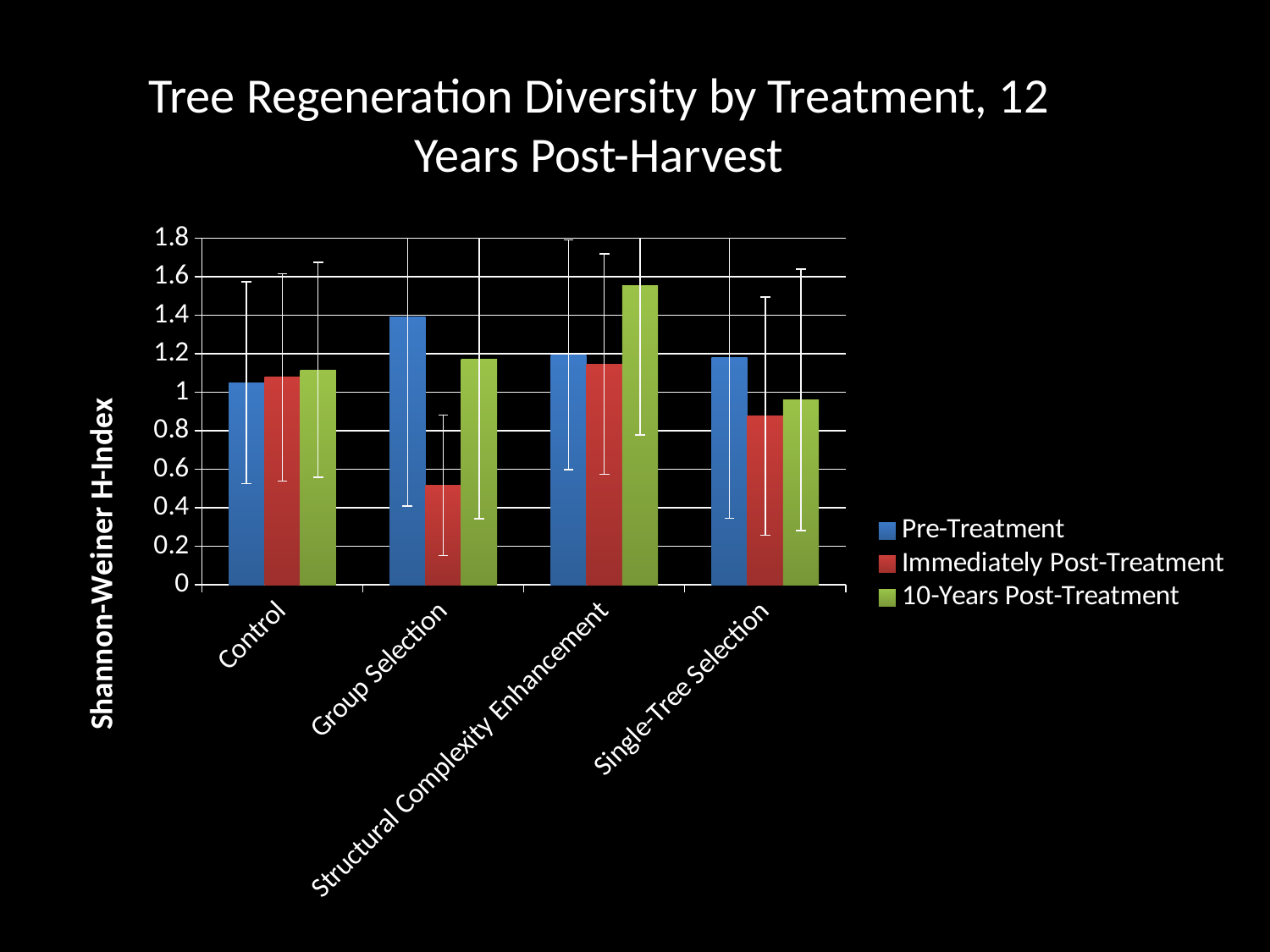
For Group Selection, which is larger: the Pre-Treatment value or the 10-Years Post-Treatment value? Pre-Treatment What kind of chart is shown on the slide? Bar chart Which is larger: the Pre-Treatment value for Group Selection or the Pre-Treatment value for Control? Group Selection Which treatment has the lowest Immediately Post-Treatment value? Group Selection What is the label on the vertical axis of the chart? Shannon-Weiner H-Index How many series does the legend list? 3 Which treatment has the highest 10-Years Post-Treatment value? Structural Complexity Enhancement Is the Immediately Post-Treatment value for Group Selection greater or less than 0.8? less Is the Pre-Treatment value for Group Selection greater or less than 1.2? greater How many treatment categories are shown on the x axis? 4 Is the 10-Years Post-Treatment value for Structural Complexity Enhancement greater or less than 1.4? greater Which series has the highest value for Group Selection? Pre-Treatment